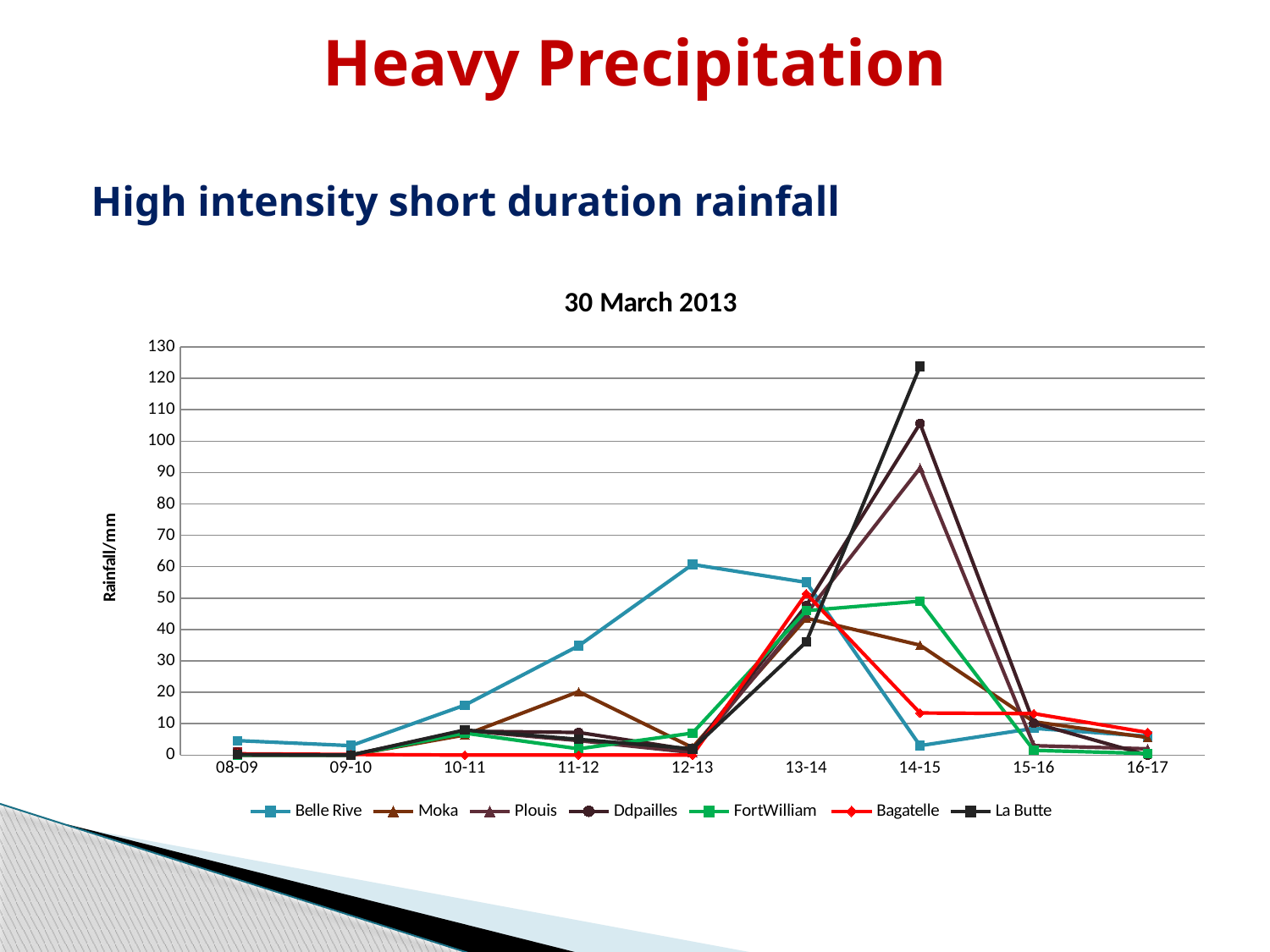
What kind of chart is shown on the slide? line chart What is the title of the chart? 30 March 2013 At 12-13, which is larger: Belle Rive or Moka? Belle Rive Is the value for Belle Rive at 12-13 greater or less than 50? greater How many series does the legend list? 7 In which time interval does the highest value on the chart occur? 14-15 Is the value for La Butte at 14-15 greater or less than 110? greater Does the Belle Rive series rise or fall from 09-10 to 12-13? rise What is the label of the y axis? Rainfall/mm Which series has the highest value at 14-15? La Butte Is the value for Ddpailles at 14-15 greater or less than 100? greater How many time intervals are shown on the x axis? 9